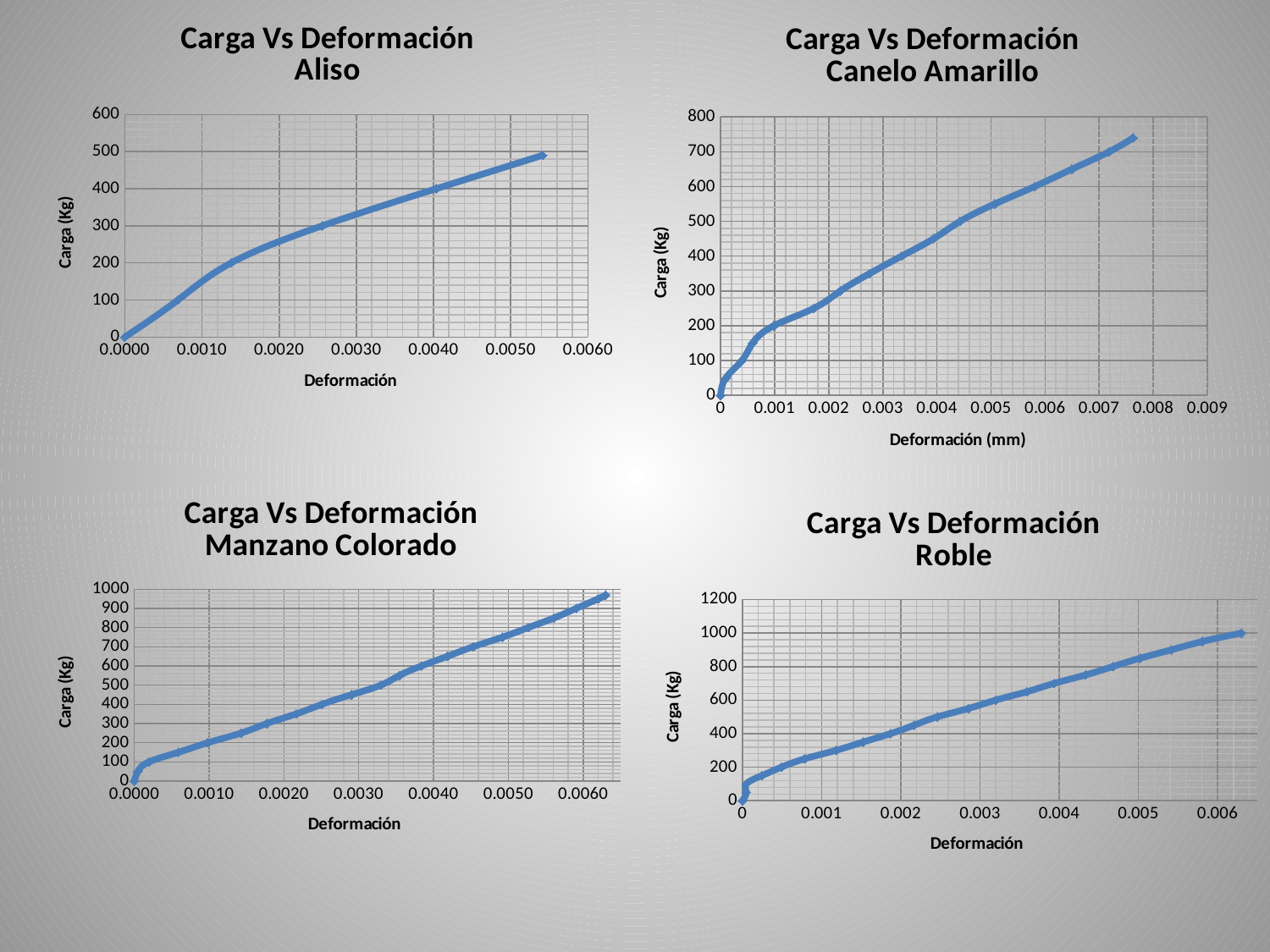
In the 'Carga Vs Deformación Roble' chart, does the load rise or fall along the x axis? Rises Which chart reaches a higher maximum load, 'Carga Vs Deformación Aliso' or 'Carga Vs Deformación Canelo Amarillo'? Carga Vs Deformación Canelo Amarillo In the 'Carga Vs Deformación Aliso' chart, is the highest load reached greater or less than 400? greater In the 'Carga Vs Deformación Aliso' chart, is the load at a Deformación of 0.0040 greater or less than 300? greater What is the y-axis title of the 'Carga Vs Deformación Roble' chart? Carga (Kg) How many charts are shown on the slide? 4 In the 'Carga Vs Deformación Aliso' chart, does the load (Carga) rise or fall as Deformación increases? Rises What kind of chart is the 'Carga Vs Deformación Aliso' chart? Line chart In the 'Carga Vs Deformación Manzano Colorado' chart, is the load at a Deformación of 0.0040 greater or less than 500? greater What is the x-axis title of the 'Carga Vs Deformación Canelo Amarillo' chart? Deformación (mm)